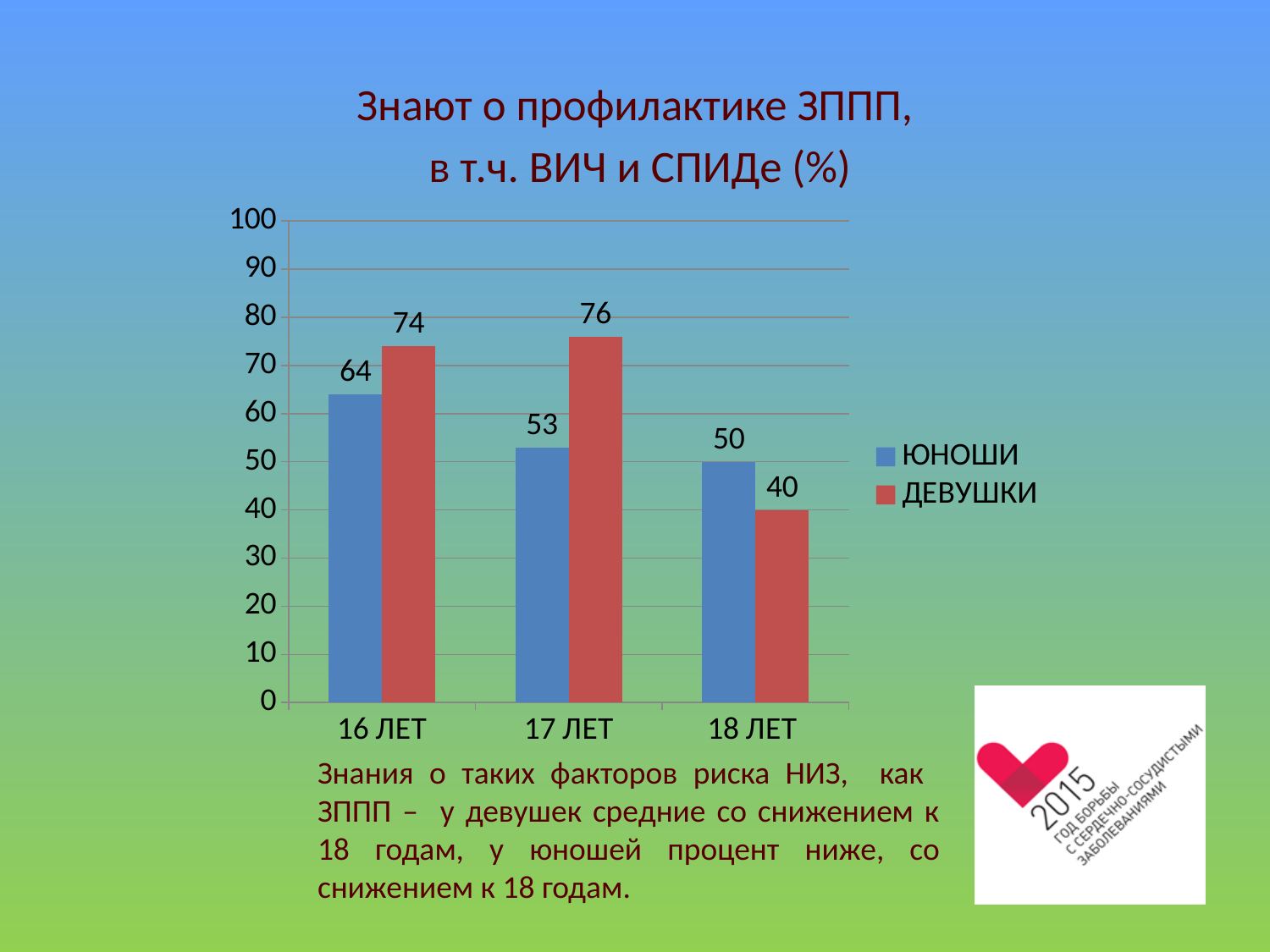
What colour are the bars for ДЕВУШКИ? red What kind of chart is shown on the slide? bar chart How many age categories are shown on the x axis? 3 Which age group has the lowest value for ЮНОШИ? 18 ЛЕТ How many series does the legend list? 2 What is the difference between ДЕВУШКИ and ЮНОШИ at 16 ЛЕТ? 10 What is the value for ЮНОШИ at 16 ЛЕТ? 64 Do the values for ЮНОШИ rise or fall from 16 ЛЕТ to 18 ЛЕТ? fall What is the value for ДЕВУШКИ at 18 ЛЕТ? 40 What is the value for ДЕВУШКИ at 17 ЛЕТ? 76 Which age group has the highest value for ДЕВУШКИ? 17 ЛЕТ At 18 ЛЕТ, which series has the larger value, ЮНОШИ or ДЕВУШКИ? ЮНОШИ